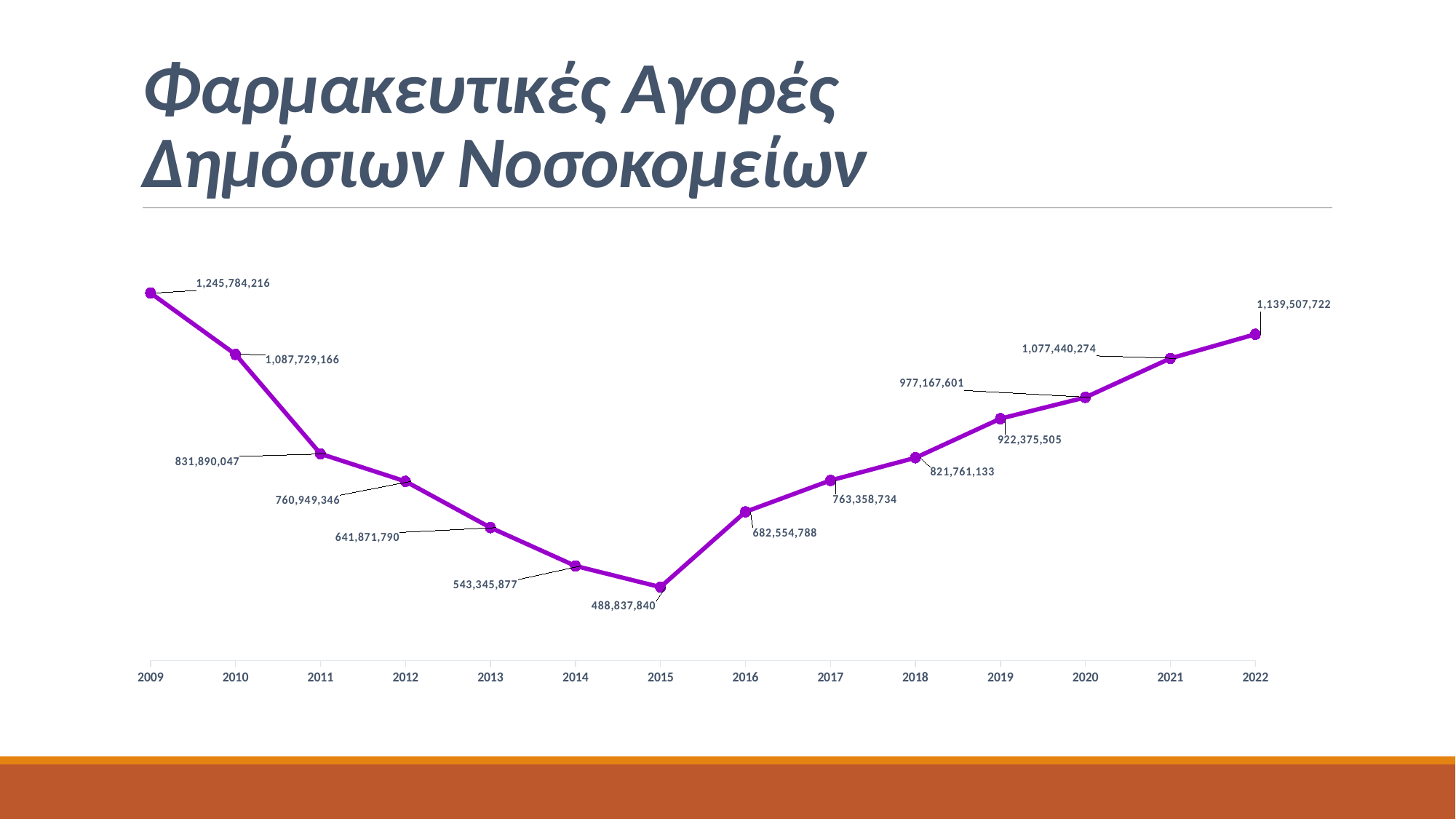
What kind of chart is shown on the slide? Line chart Which year has the lowest value? 2015 What is the value for 2009? 1,245,784,216 What is the value for 2015? 488,837,840 Do the values rise or fall from 2009 to 2015? Fall What is the difference between the values for 2009 and 2015? 756,946,376 What is the value for 2018? 821,761,133 How many years are plotted on the chart? 14 What is the value for 2022? 1,139,507,722 What is the difference between the values for 2022 and 2021? 62,067,448 Which year has the highest value? 2009 Which is larger, the value for 2011 or the value for 2019? 2019